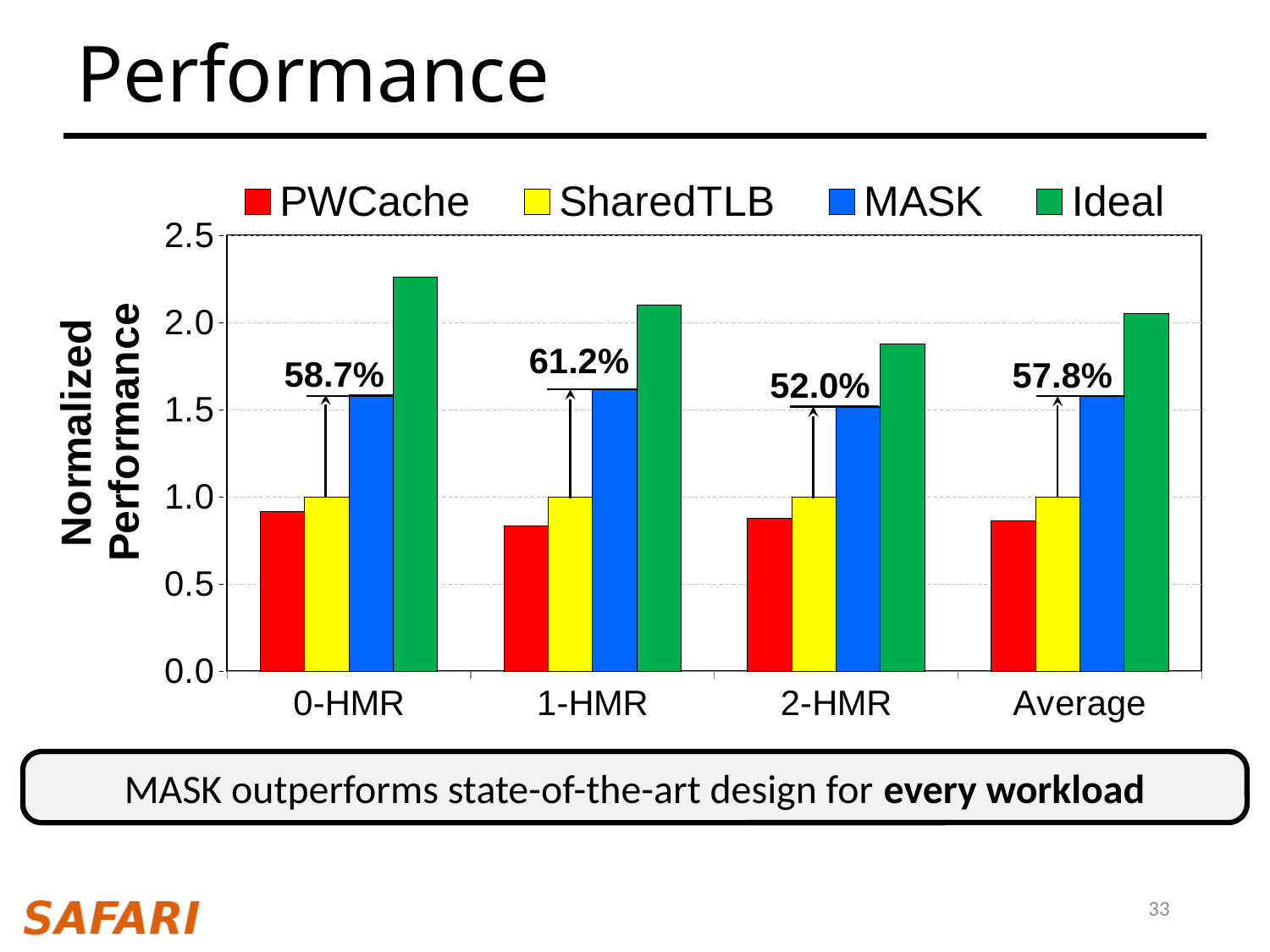
What improvement percentage is annotated above the Average group? 57.8% How many series does the legend list? 4 Is the MASK value for 1-HMR greater or less than 1.5? greater Is the Ideal value for 0-HMR greater or less than 2.0? greater Which is larger, the Ideal bar for 0-HMR or the Ideal bar for 1-HMR? 0-HMR Which group has the smallest annotated improvement percentage? 2-HMR Which series has the lowest bar for 1-HMR? PWCache Which series has the highest bar for 0-HMR? Ideal What improvement percentage is annotated above the 1-HMR group? 61.2% What kind of chart is shown on the slide? bar chart Is the Ideal value for 2-HMR greater or less than 2.0? less How many workload categories are shown on the x axis? 4